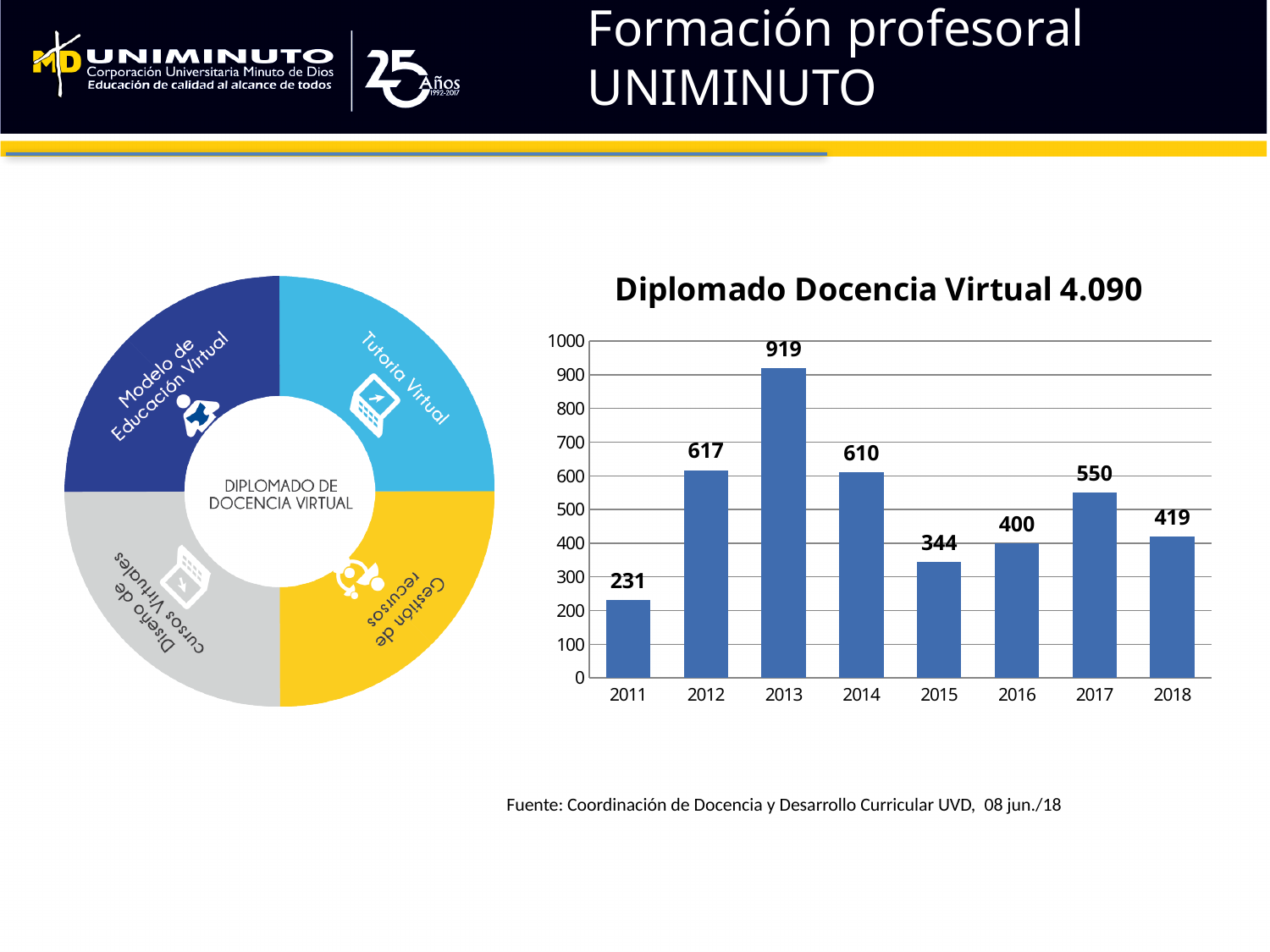
What is the value for 2017 in the bar chart? 550 Which year has the highest value in the bar chart? 2013 What is the value for 2011 in the bar chart? 231 Which is larger in the bar chart, the value for 2016 or the value for 2018? 2018 What is the title of the bar chart? Diplomado Docencia Virtual 4.090 What is the difference between the values for 2013 and 2011 in the bar chart? 688 What kind of chart is used to show the Diplomado Docencia Virtual data? bar chart Is the value for 2015 in the bar chart greater or less than 400? less Which year has the lowest value in the bar chart? 2011 How many years are shown on the x axis of the bar chart? 8 What is the value for 2013 in the bar chart? 919 What is the difference between the values for 2012 and 2014 in the bar chart? 7